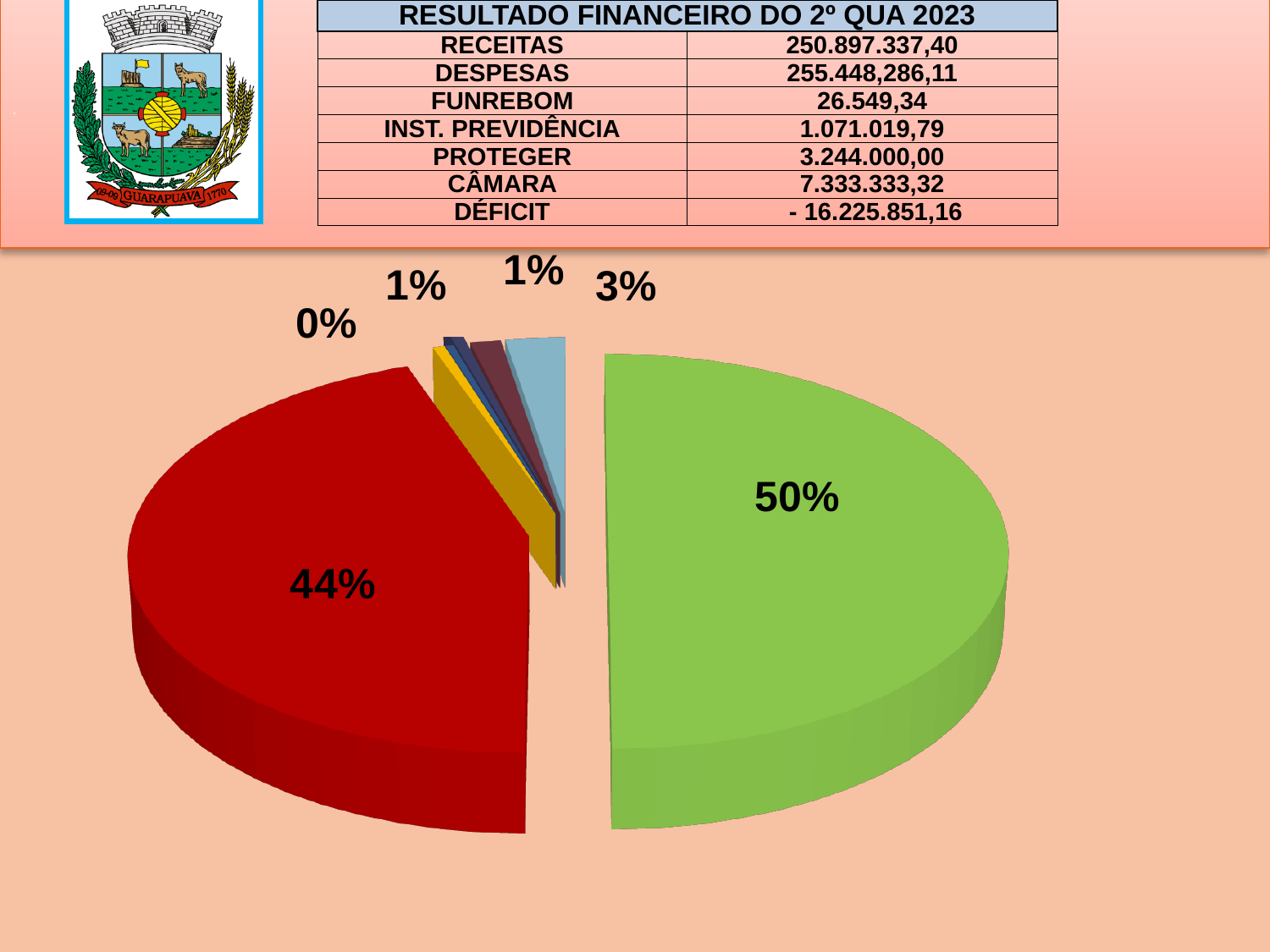
What kind of chart is shown on the slide? pie chart Does the pie chart include a legend? No What is the share of the largest slice in the pie chart? 50% What is the share of the smallest slice in the pie chart? 0% What is the difference in percentage points between the two largest slices of the pie chart? 6 percentage points Is the largest slice of the pie chart greater or less than 40%? greater What is the share of the second-largest slice in the pie chart? 44% What is the combined share of the two largest slices in the pie chart? 94% What share is shown on the green slice of the pie chart? 50%